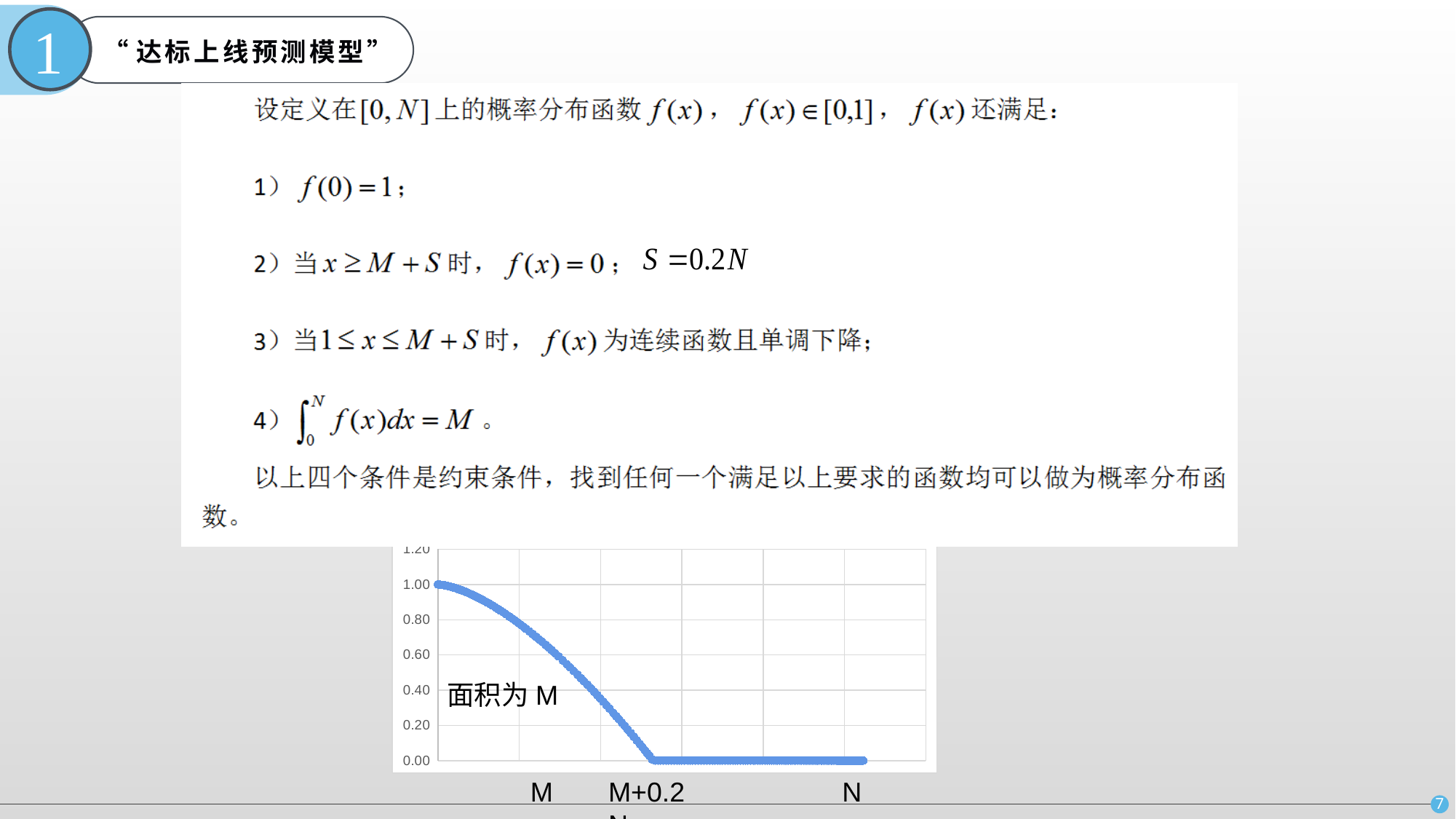
What is the highest value reached by the plotted curve? 1.00 What kind of chart is shown at the bottom of the slide? line chart Is the value of the curve at x = M greater or less than 0.20? greater What text annotation is written inside the chart area? 面积为 M What is the lowest value reached by the plotted curve? 0.00 Is the value of the curve at x = 0 greater or less than 0.80? greater What is the highest tick label shown on the y axis of the chart? 1.20 What is the value of the plotted curve at x = M+0.2N? 0.00 What is the value of the plotted curve at x = N? 0.00 Which is larger: the curve's value at x = 0 or its value at x = N? x = 0 Do the plotted values rise or fall as x increases along the x axis? fall What is the value of the plotted curve at the left end of the x axis (x = 0)? 1.00